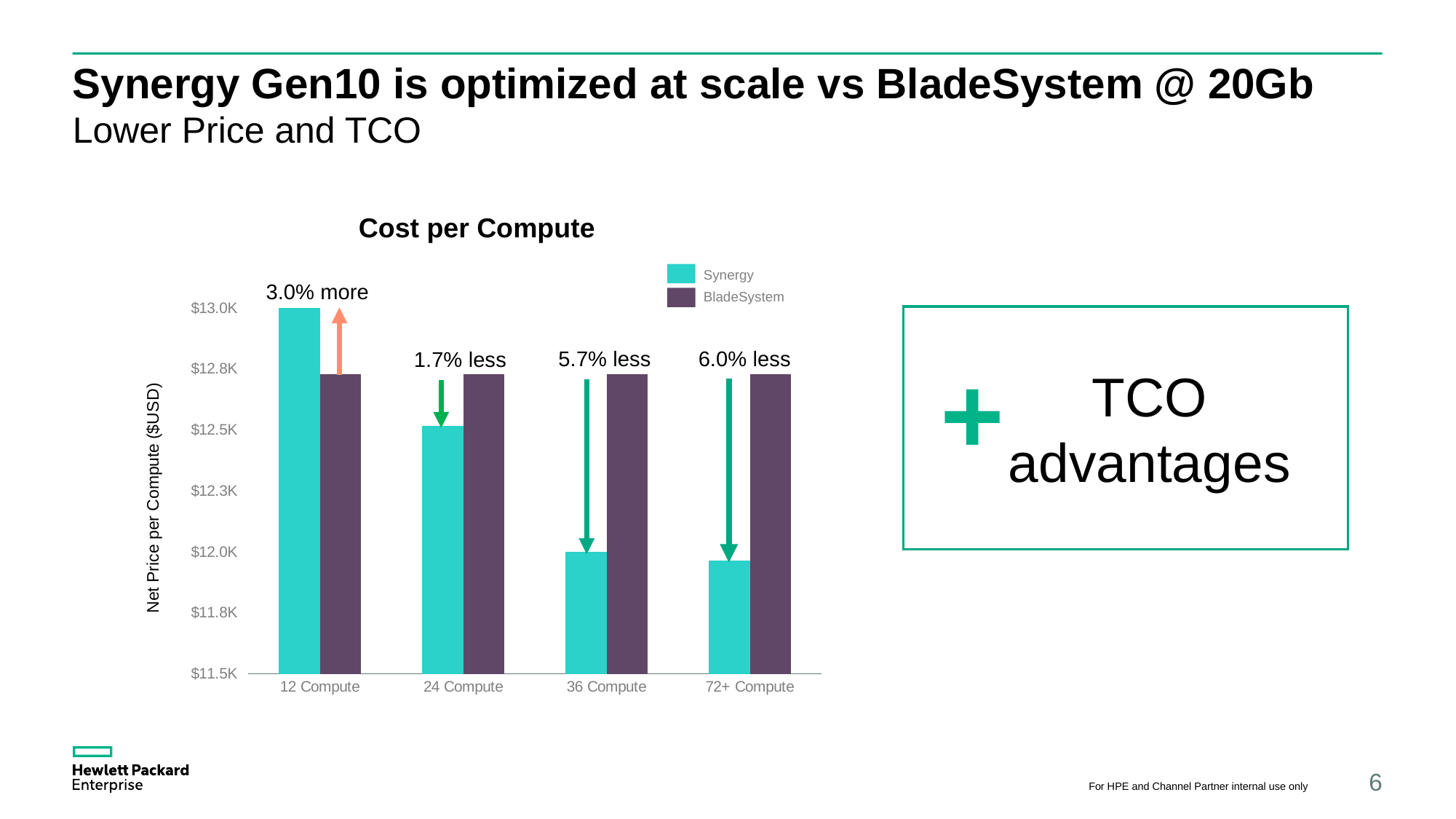
At 36 Compute, which is larger, the Synergy value or the BladeSystem value? BladeSystem How many series does the chart's legend list? 2 What percentage annotation is shown above the 12 Compute bars? 3.0% more What percentage annotation is shown above the 72+ Compute bars? 6.0% less How many compute categories are shown on the x axis of the chart? 4 What kind of chart is shown on the slide? bar chart Which compute category has the highest Synergy value? 12 Compute Which compute category has the lowest Synergy value? 72+ Compute What percentage annotation is shown above the 36 Compute bars? 5.7% less What is the y-axis label of the chart? Net Price per Compute ($USD) Is the BladeSystem value for 24 Compute greater or less than $12.5K? greater What is the title of the chart on the slide? Cost per Compute